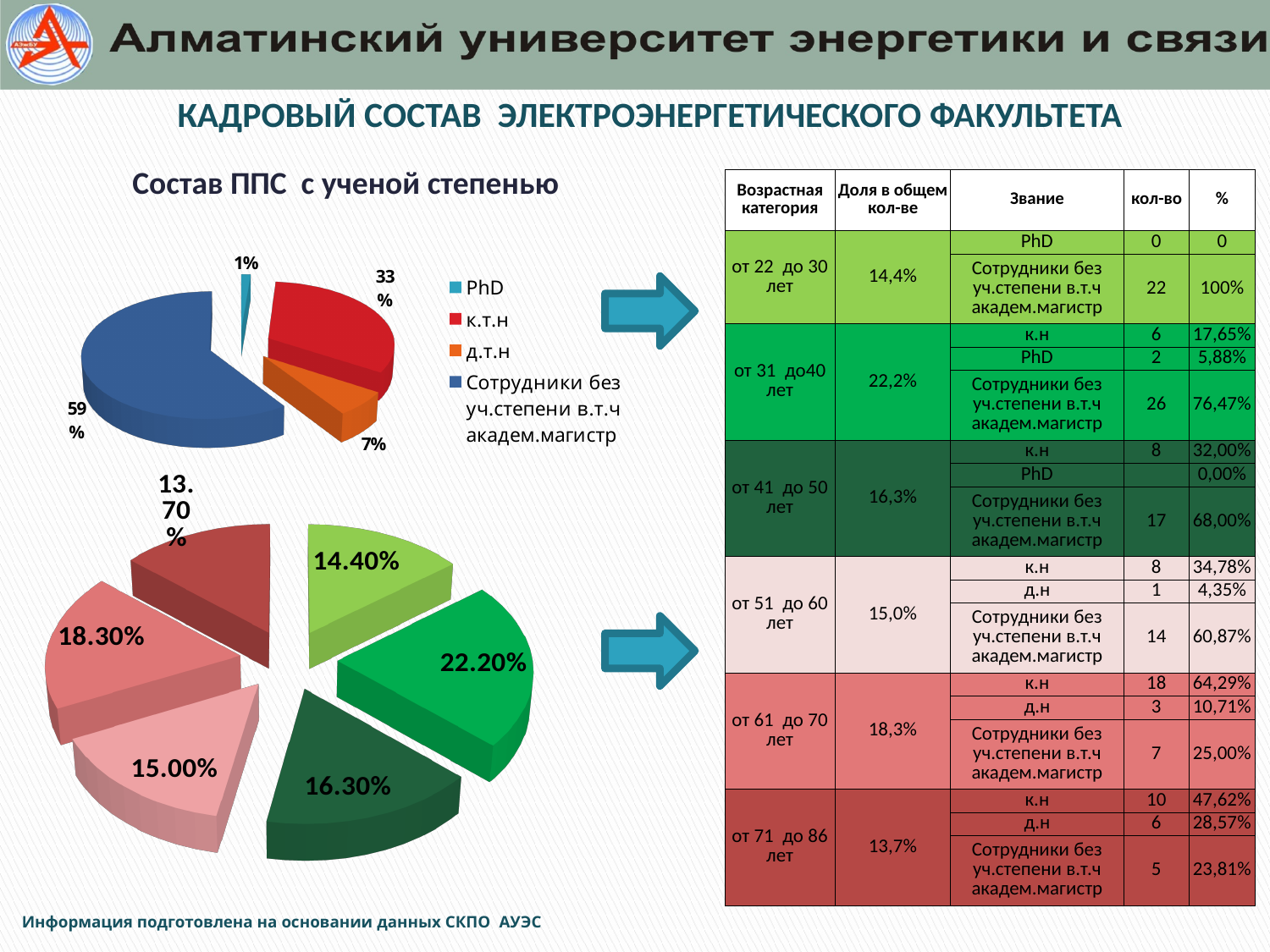
In the top pie chart 'Состав ППС с ученой степенью', which category has the smallest share? PhD In the top pie chart 'Состав ППС с ученой степенью', how many categories does the legend list? 4 In the top pie chart 'Состав ППС с ученой степенью', what share is shown for к.т.н? 33% In the top pie chart 'Состав ППС с ученой степенью', which category has the largest share? Сотрудники без уч.степени в.т.ч академ.магистр In the top pie chart 'Состав ППС с ученой степенью', what is the difference in percentage points between к.т.н and д.т.н? 26 In the bottom pie chart, what is the largest percentage shown on a slice? 22.20% In the top pie chart 'Состав ППС с ученой степенью', what share is shown for д.т.н? 7% In the bottom pie chart, what is the smallest percentage shown on a slice? 13.70% What kind of chart is the top chart 'Состав ППС с ученой степенью'? pie chart In the top pie chart 'Состав ППС с ученой степенью', what share is shown for 'Сотрудники без уч.степени в.т.ч академ.магистр'? 59% How many slices does the bottom pie chart have? 6 In the top pie chart 'Состав ППС с ученой степенью', what share is shown for PhD? 1%